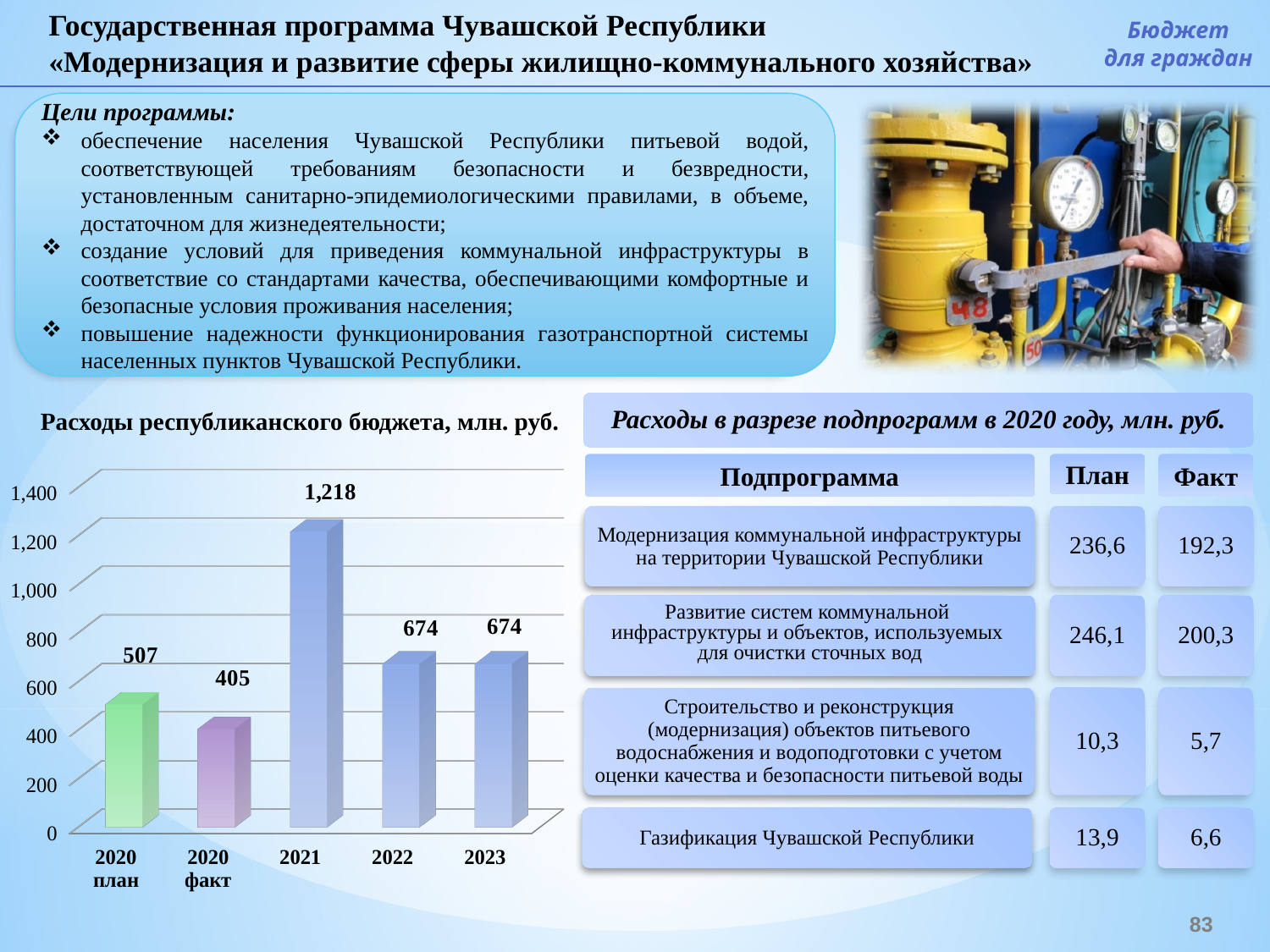
What is the value for 2021 in the chart 'Расходы республиканского бюджета, млн. руб.'? 1,218 How many bars are shown in the chart? 5 Which category has the highest value in the chart? 2021 What type of chart is shown on the slide? bar chart Is the value for 2021 greater or less than 1,000? greater What is the value for '2020 план' in the chart? 507 What is the value for '2020 факт' in the chart? 405 What is the difference between the values for '2020 план' and '2020 факт'? 102 What is the difference between the values for 2021 and 2022? 544 Which is larger, the value for 2021 or the value for 2022? 2021 Which category has the lowest value in the chart? 2020 факт What is the value for 2023 in the chart? 674